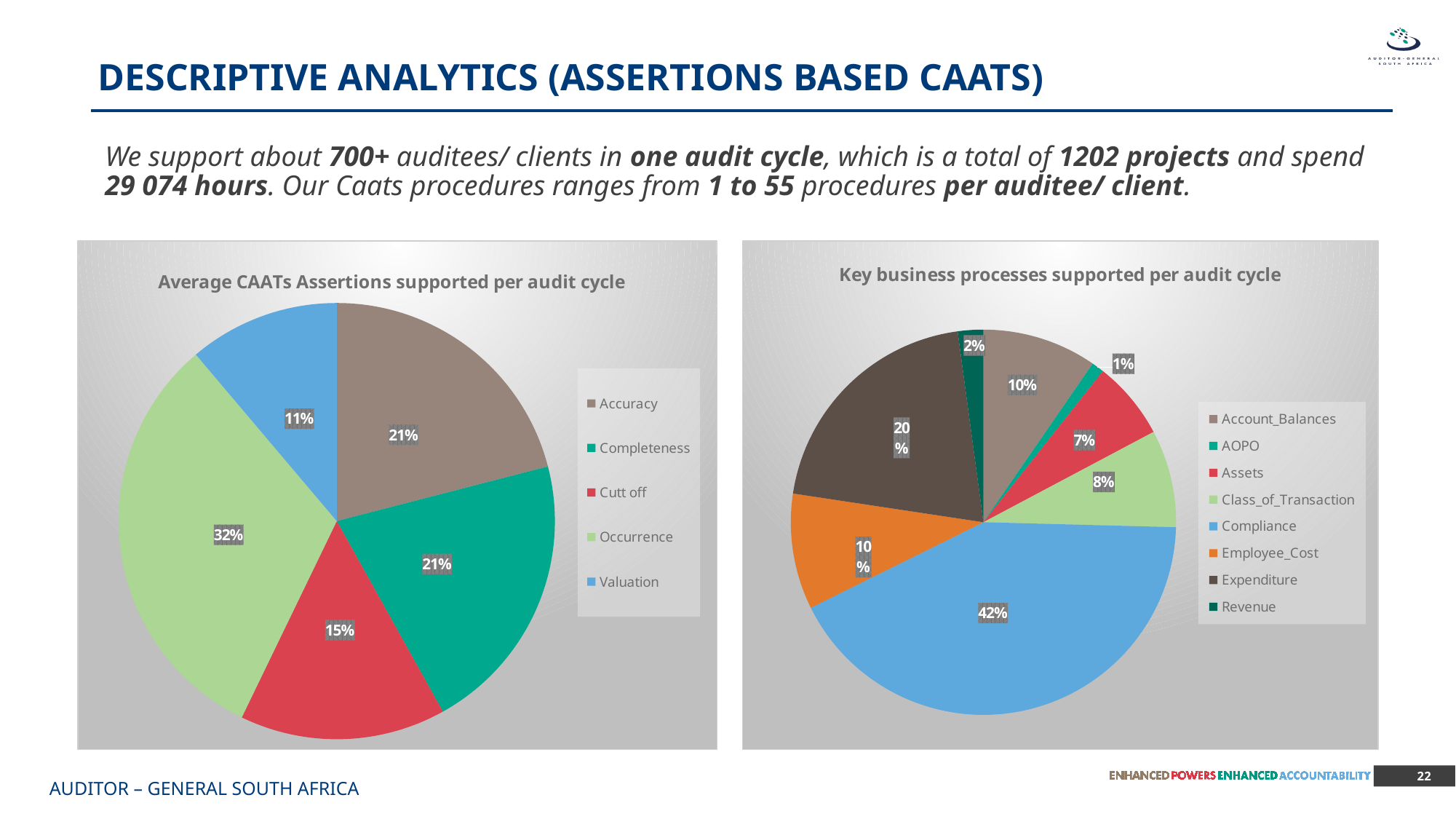
In the 'Average CAATs Assertions supported per audit cycle' chart, what share does Occurrence have? 32% In the 'Key business processes supported per audit cycle' chart, what is the difference between Compliance and Expenditure? 22% In the 'Average CAATs Assertions supported per audit cycle' chart, what is the difference between Occurrence and Valuation? 21% What kind of chart is the 'Key business processes supported per audit cycle' chart? Pie chart How many categories does the legend of the 'Key business processes supported per audit cycle' chart list? 8 In the 'Average CAATs Assertions supported per audit cycle' chart, which category has the smallest slice? Valuation In the 'Average CAATs Assertions supported per audit cycle' chart, what is the value for Cutt off? 15% In the 'Key business processes supported per audit cycle' chart, which category has the smallest share? AOPO In the 'Key business processes supported per audit cycle' chart, what is the value for Expenditure? 20% How many categories does the legend of the 'Average CAATs Assertions supported per audit cycle' chart list? 5 In the 'Key business processes supported per audit cycle' chart, which category has the largest share? Compliance In the 'Key business processes supported per audit cycle' chart, which is larger: Assets or Class_of_Transaction? Class_of_Transaction